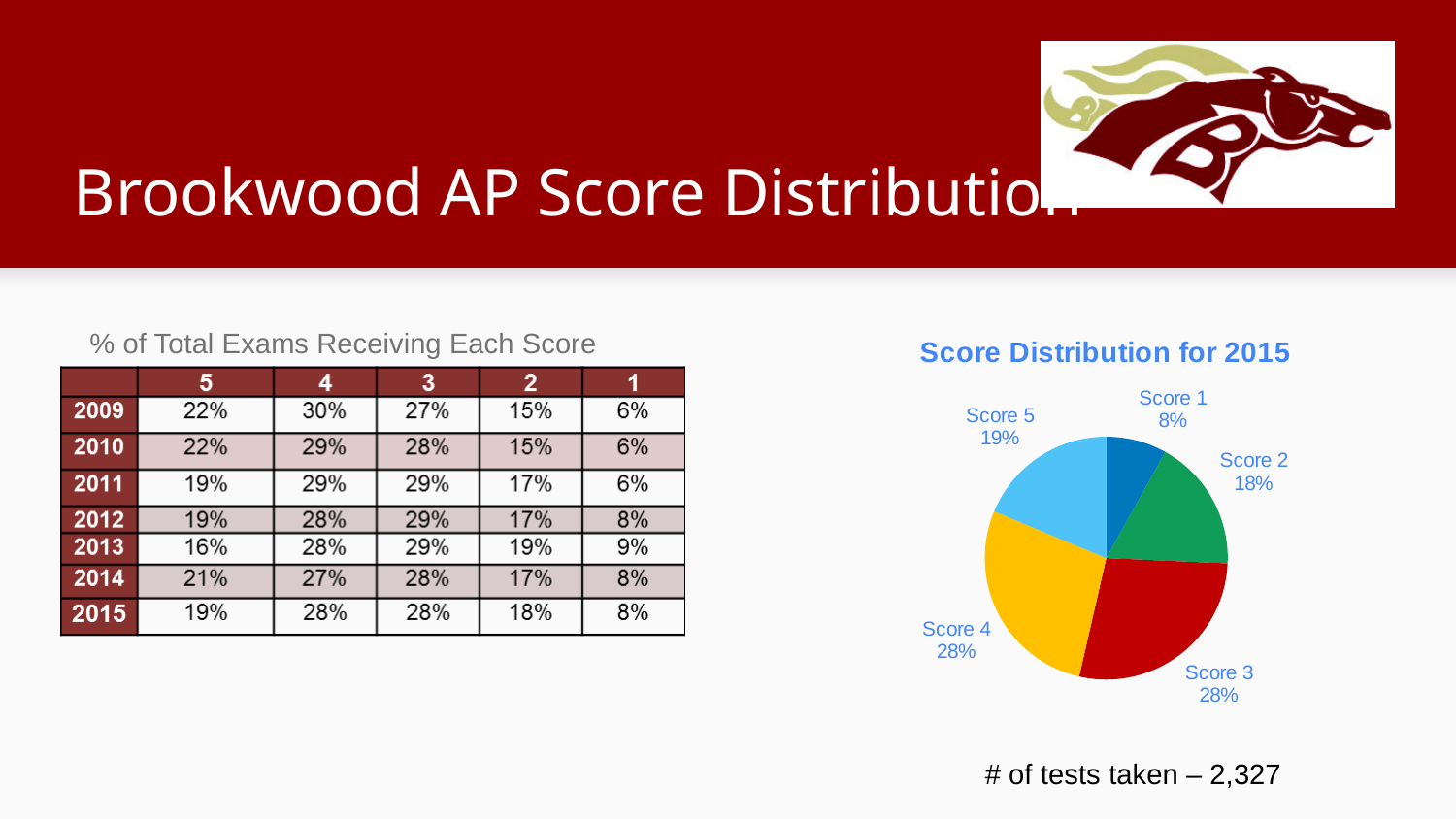
What is the difference between the share for Score 3 and the share for Score 1? 20% What is the value shown for Score 3 in the pie chart? 28% Which is larger, the slice for Score 2 or the slice for Score 5? Score 5 How many slices does the pie chart have? 5 Which score has the smallest slice of the pie? Score 1 What share of the pie does Score 2 represent? 18% What is the difference between the share for Score 5 and the share for Score 2? 1% What is the value shown for Score 4 in the pie chart? 28% What kind of chart is shown on the slide? pie chart What is the title of the chart? Score Distribution for 2015 What share of the pie does Score 1 represent? 8% What share of the pie does Score 5 represent? 19%